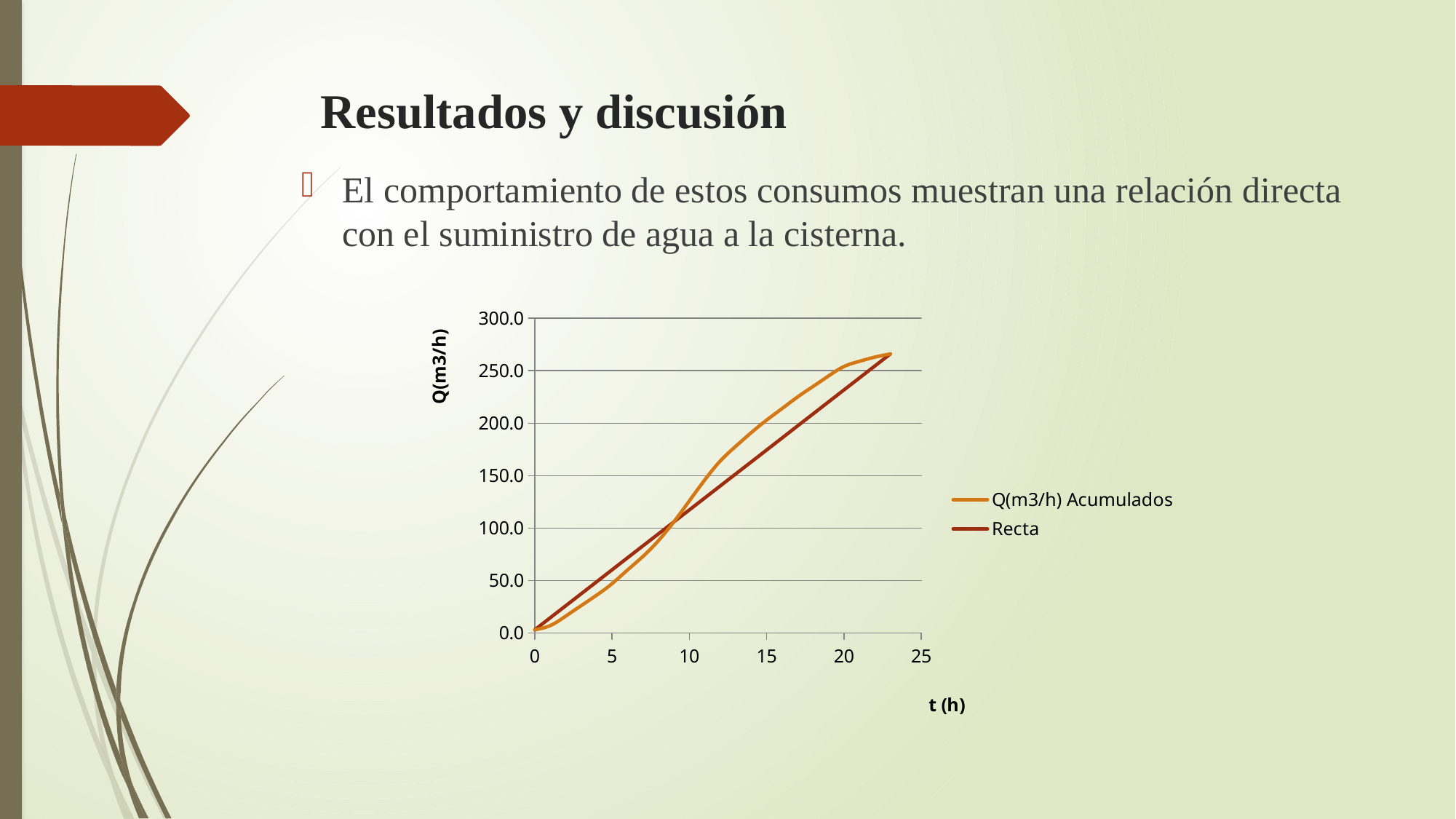
At t = 5, which series has the higher value, Q(m3/h) Acumulados or Recta? Recta Do the values of the Recta series rise or fall along the x axis? rise What are the two series named in the chart legend? Q(m3/h) Acumulados and Recta What kind of chart is shown on the slide? line chart At t = 5, is the value of Q(m3/h) Acumulados greater or less than 100.0? less What is the label of the horizontal axis of the chart? t (h) How many series does the chart legend list? 2 What is the highest value shown on the vertical axis of the chart? 300.0 At t = 20, is the value of Q(m3/h) Acumulados greater or less than 200.0? greater At t = 15, is the value of Q(m3/h) Acumulados greater or less than 150.0? greater At t = 15, which series has the higher value, Q(m3/h) Acumulados or Recta? Q(m3/h) Acumulados Do the values of the Q(m3/h) Acumulados series rise or fall as t increases? rise